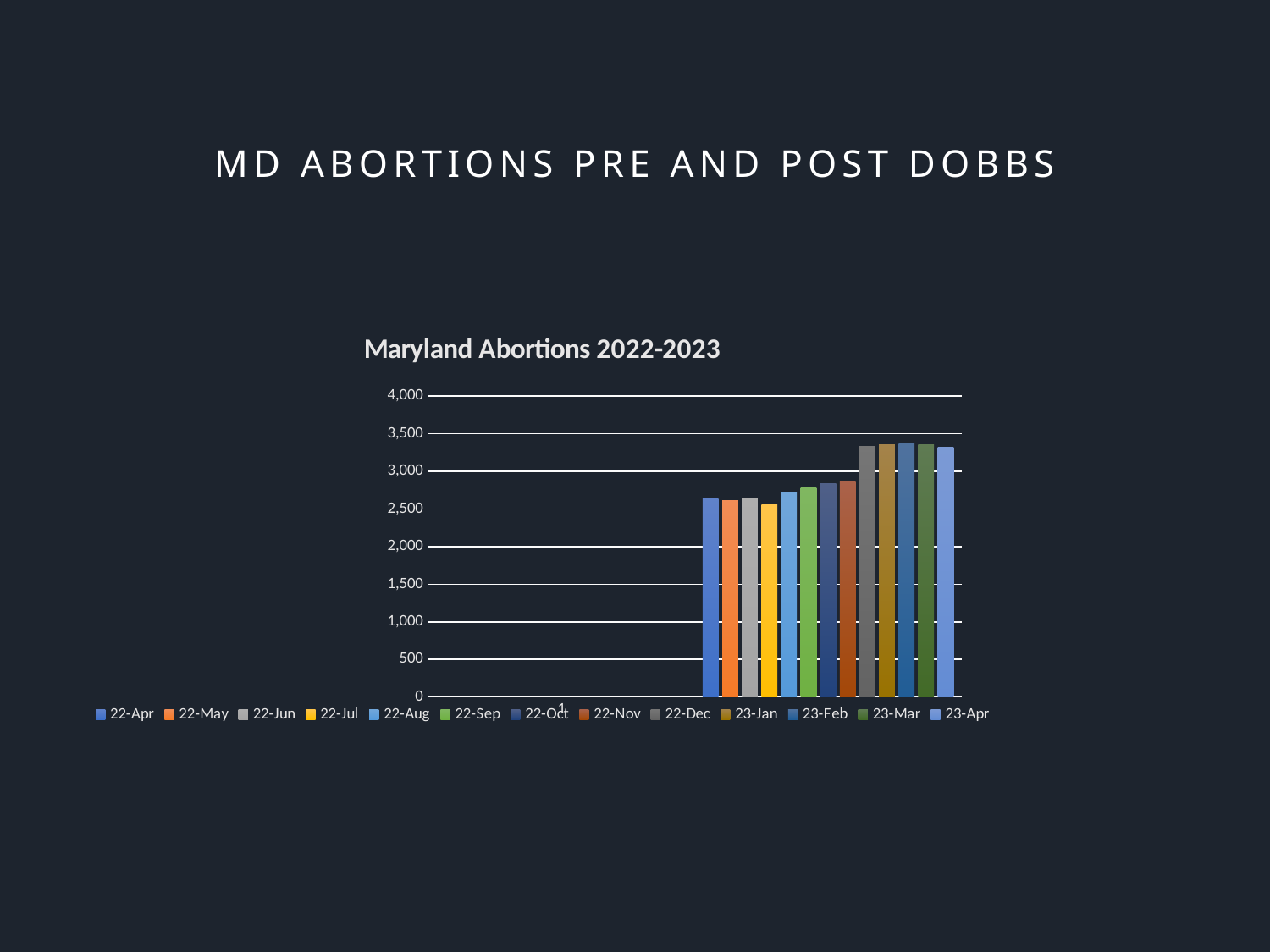
What is the title of the chart? Maryland Abortions 2022-2023 Which is larger, the value for 23-Jan or the value for 22-Jul? 23-Jan How many series does the legend list? 13 Is the value for 23-Jan greater or less than 3,000? greater What kind of chart is shown on the slide? bar chart Is the value for 22-Nov greater or less than 2,500? greater Is the value for 22-Jul greater or less than 3,000? less Which is larger, the value for 22-Apr or the value for 22-Dec? 22-Dec How many bars are plotted in the chart? 13 What is the highest value shown on the vertical axis? 4,000 Do the values generally rise or fall from 22-Apr to 23-Apr? rise